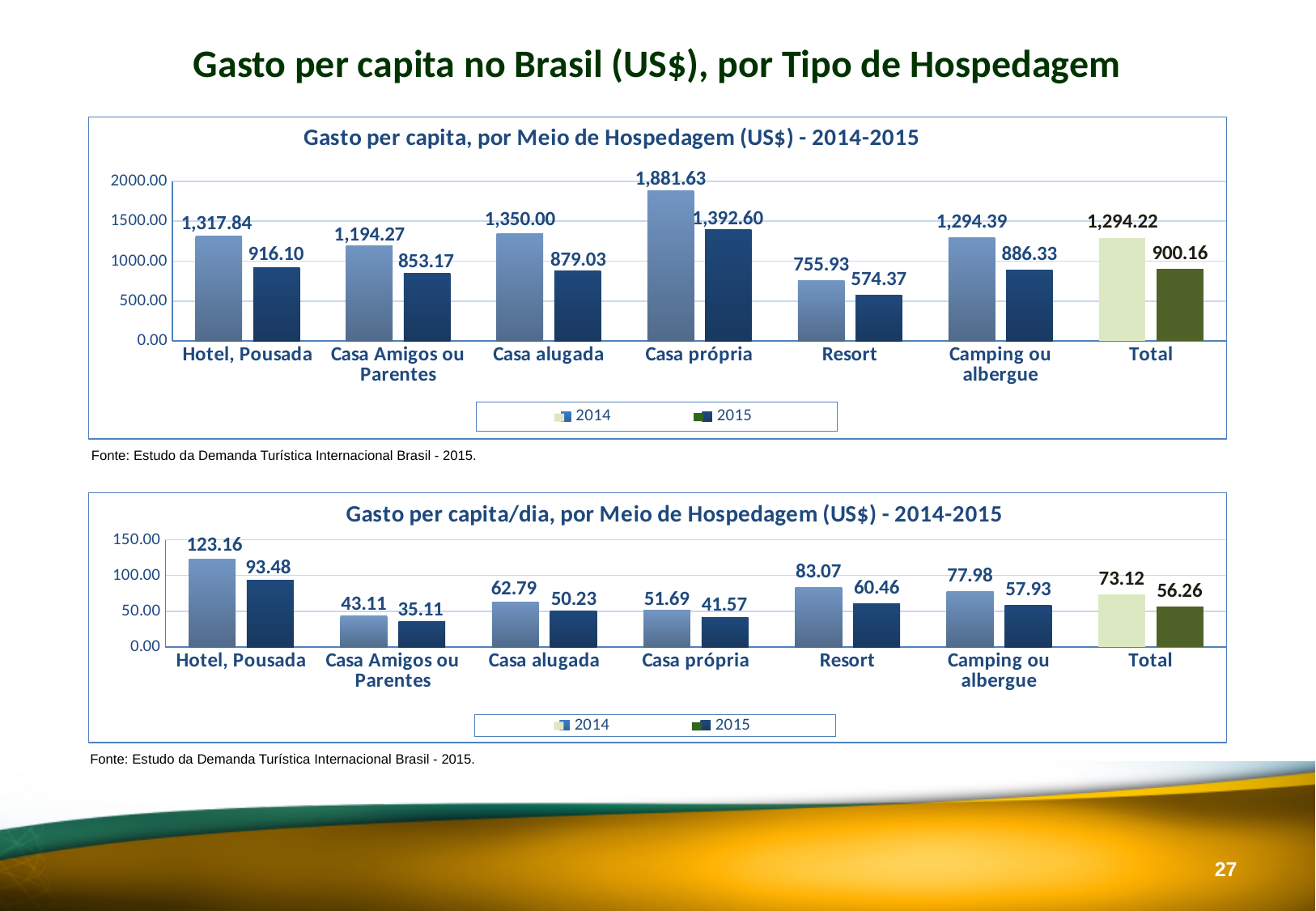
In the bottom chart (Gasto per capita/dia, por Meio de Hospedagem), what is the 2015 value for Camping ou albergue? 57.93 What kind of chart is the bottom chart (Gasto per capita/dia, por Meio de Hospedagem)? Bar chart In the bottom chart (Gasto per capita/dia, por Meio de Hospedagem), which category has the lowest 2014 value? Casa Amigos ou Parentes In the top chart (Gasto per capita, por Meio de Hospedagem), what is the 2014 value for Casa própria? 1,881.63 In the bottom chart (Gasto per capita/dia, por Meio de Hospedagem), what is the difference between the 2014 and 2015 Total values? 16.86 In the top chart (Gasto per capita, por Meio de Hospedagem), what is the difference between the 2014 and 2015 values for Hotel, Pousada? 401.74 In the top chart (Gasto per capita, por Meio de Hospedagem), what is the 2015 value for Resort? 574.37 In the top chart (Gasto per capita, por Meio de Hospedagem), which category has the highest 2014 value? Casa própria In the bottom chart (Gasto per capita/dia, por Meio de Hospedagem), which is larger: the 2014 value for Resort or the 2014 value for Camping ou albergue? Resort In the top chart (Gasto per capita, por Meio de Hospedagem), how many series does the legend list? 2 In the top chart (Gasto per capita, por Meio de Hospedagem), which category has the lowest 2015 value? Resort In the bottom chart (Gasto per capita/dia, por Meio de Hospedagem), how many categories are shown on the x axis? 7